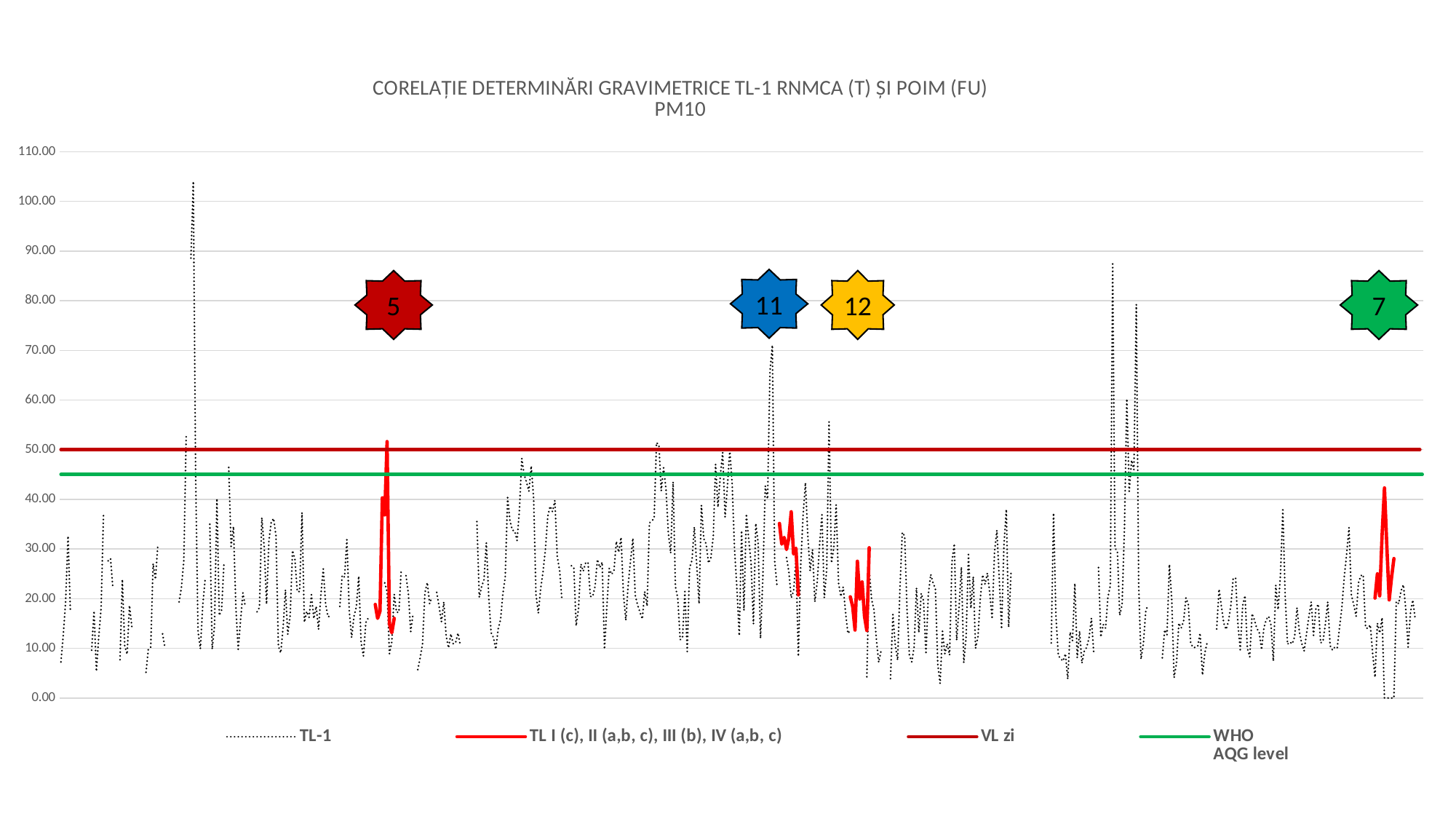
Is the WHO AQG level line greater or less than 50? less What value does the VL zi line sit at? 50.00 Which series reaches the highest value on the chart? TL-1 What kind of chart is shown on the slide? line chart Is the WHO AQG level line greater or less than 40? greater How many series does the legend list? 4 Is the highest value of the red TL I (c), II (a,b, c), III (b), IV (a,b, c) series greater or less than 60? less Which series is drawn in green? WHO AQG level What is the title of the chart? CORELAȚIE DETERMINĂRI GRAVIMETRICE TL-1 RNMCA (T) ȘI POIM (FU) PM10 Which is higher, the VL zi line or the WHO AQG level line? VL zi